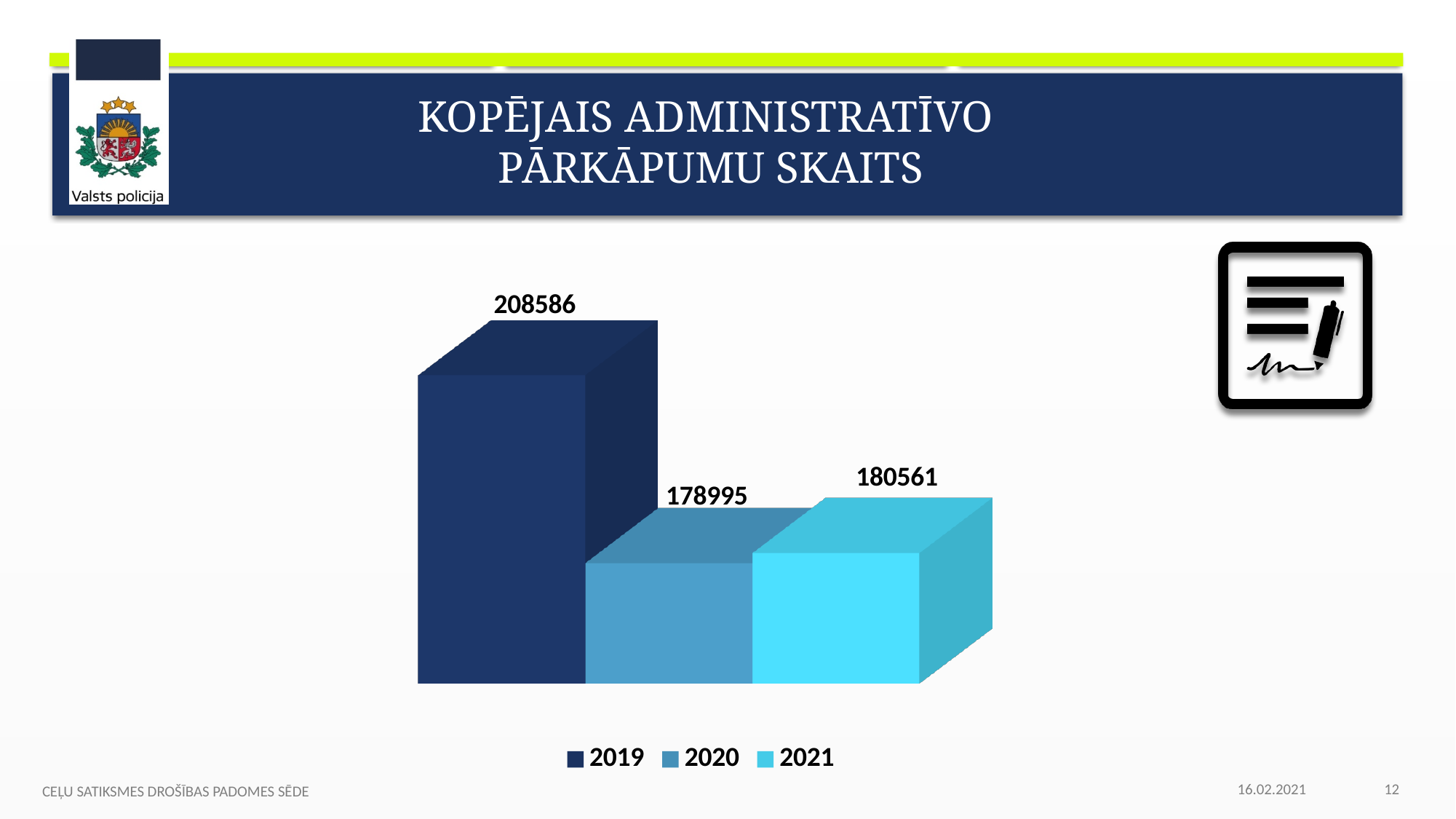
What is the difference between the values for 2019 and 2020? 29591 What is the value shown for 2020? 178995 What kind of chart is shown on the slide? Bar chart What is the value shown for 2021? 180561 What is the difference between the values for 2021 and 2020? 1566 How many entries does the legend list? 3 How many bars are plotted in the chart? 3 What is the title of the slide containing the chart? KOPĒJAIS ADMINISTRATĪVO PĀRKĀPUMU SKAITS Which year has the highest value? 2019 What is the value shown for 2019? 208586 Which is larger, the value for 2020 or the value for 2021? 2021 Which year has the lowest value? 2020